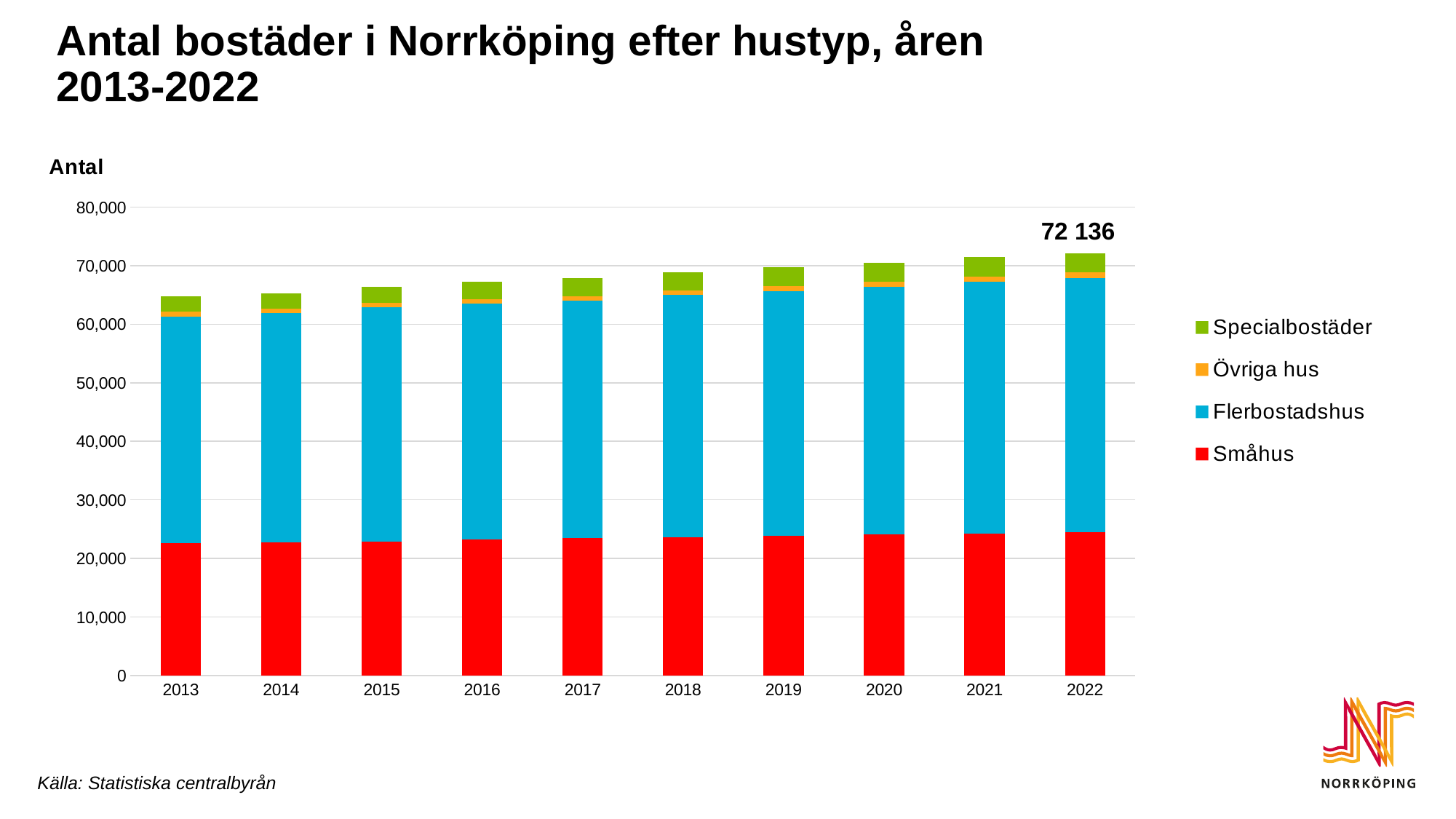
Which series is shown in red? Småhus Which is larger, the total for 2022 or the total for 2013? 2022 Is the total bar for 2013 greater or less than 60,000? greater What is the total number of dwellings shown for 2022? 72 136 Which year has the highest total number of dwellings? 2022 How many series does the legend list? 4 What kind of chart is shown on the slide? Stacked bar chart Is the total bar for 2018 greater or less than 70,000? less What is the source cited for the chart? Statistiska centralbyrån How many years are shown on the x axis of the chart? 10 Do the total bar heights rise or fall from 2013 to 2022? Rise Is the Småhus value for 2013 greater or less than 30,000? less